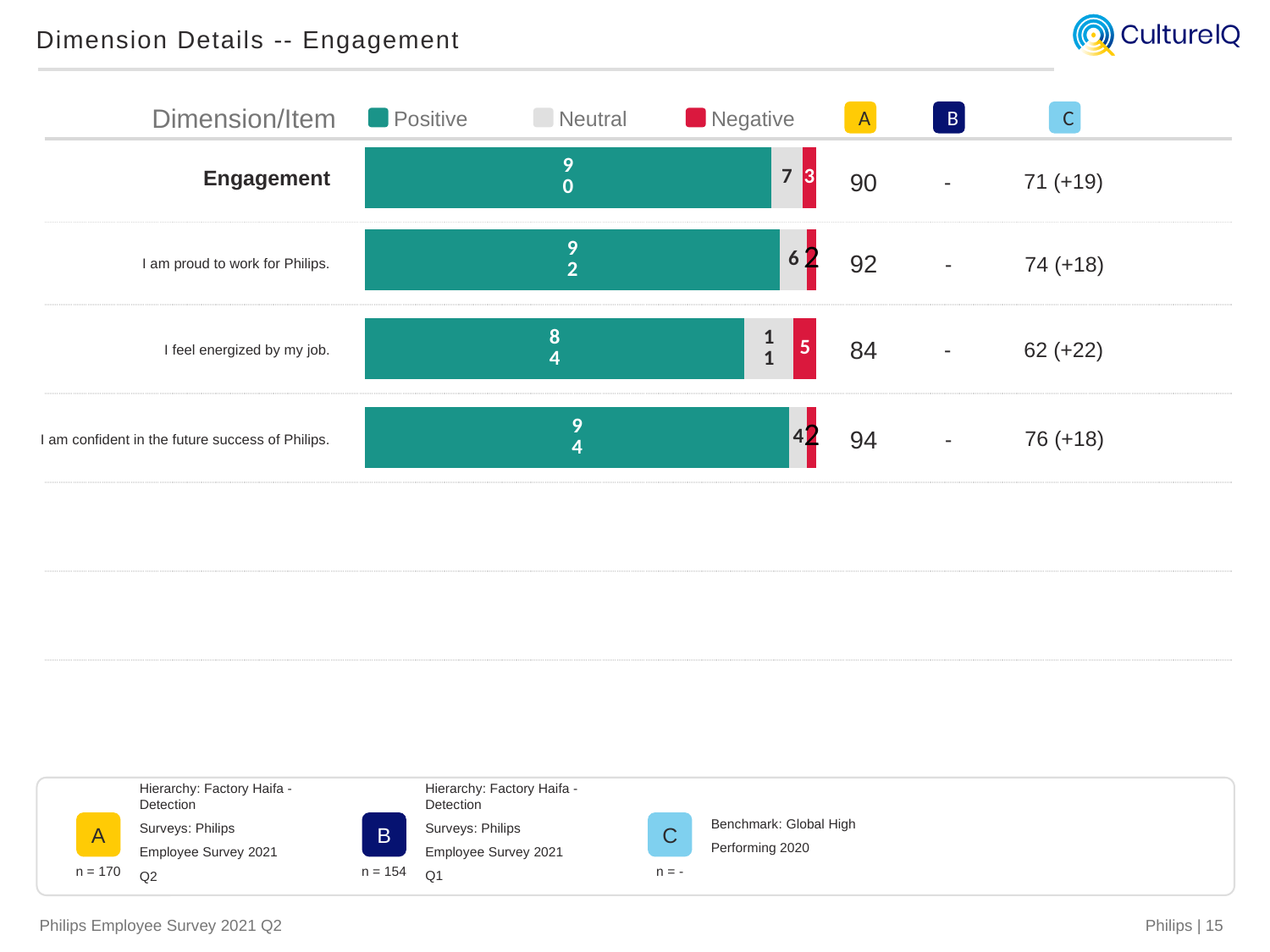
How many series does the legend list? 3 What is the difference between the Positive values for "I am confident in the future success of Philips." and "I feel energized by my job."? 10 Which item has the lowest Positive value? I feel energized by my job. What kind of chart is shown on the slide? Stacked bar chart Which colour represents the Negative series in the legend? Red What is the total of the stacked bar for "Engagement"? 100 Which has a larger Neutral value: "Engagement" or "I feel energized by my job."? I feel energized by my job. What is the Negative value for "I feel energized by my job."? 5 Which item has the highest Positive value? I am confident in the future success of Philips. How many rows (dimension/items) are plotted in the chart? 4 What is the Positive value for "I am proud to work for Philips."? 92 What is the Neutral value for "I am confident in the future success of Philips."? 4